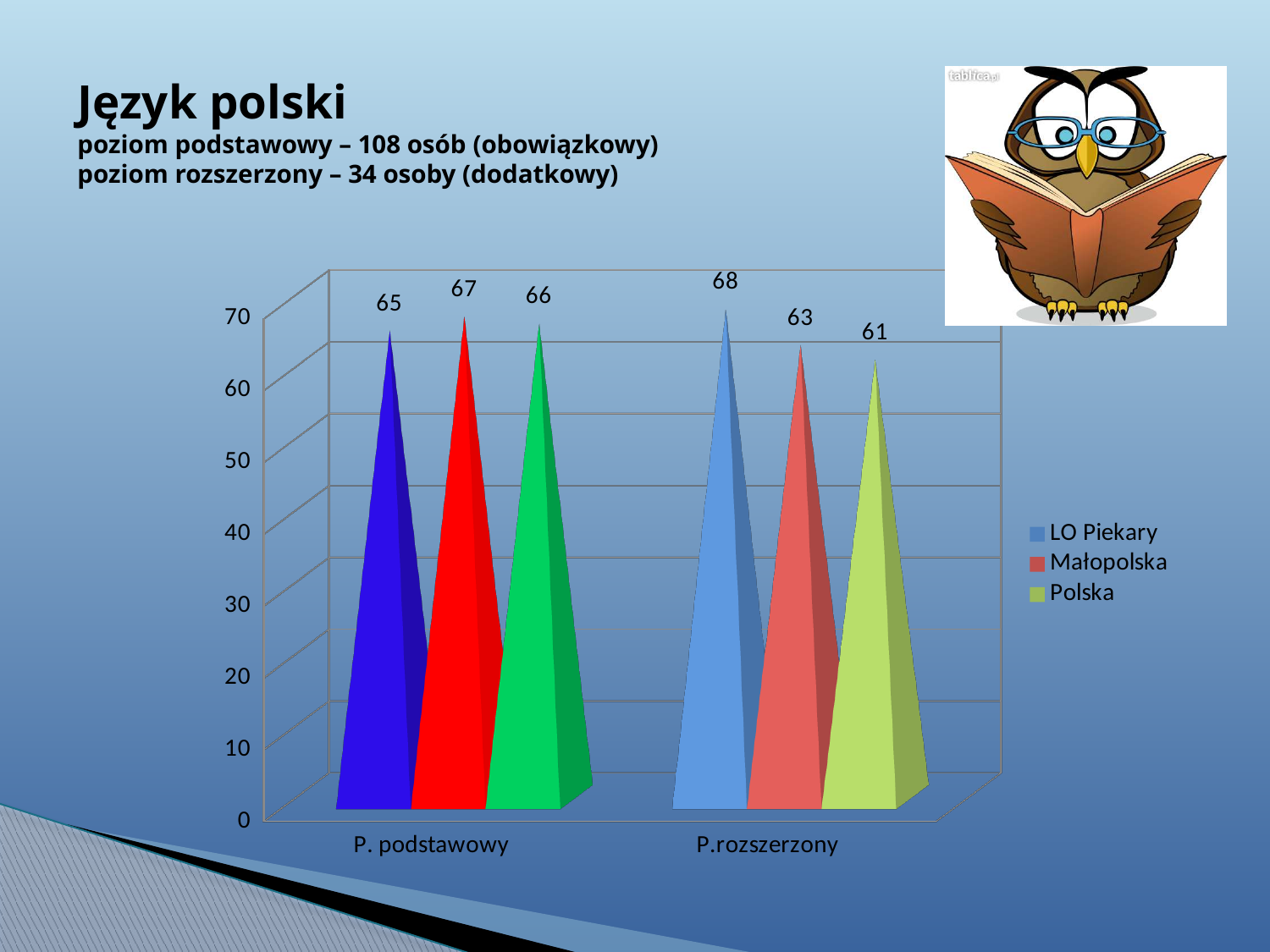
What kind of chart is shown on the slide? Bar chart How many categories are shown on the x axis? 2 Which is larger: the Małopolska value for P. podstawowy or the Małopolska value for P.rozszerzony? P. podstawowy How many series does the legend list? 3 What is the difference between the LO Piekary and Polska values in the P.rozszerzony category? 7 What is the value for Polska in the P.rozszerzony category? 61 Which series has the highest value in the P.rozszerzony category? LO Piekary What is the value for Małopolska in the P. podstawowy category? 67 Which colour represents Polska in the legend? Green What is the value for LO Piekary in the P. podstawowy category? 65 Which series has the lowest value in the P. podstawowy category? LO Piekary What is the value for LO Piekary in the P.rozszerzony category? 68